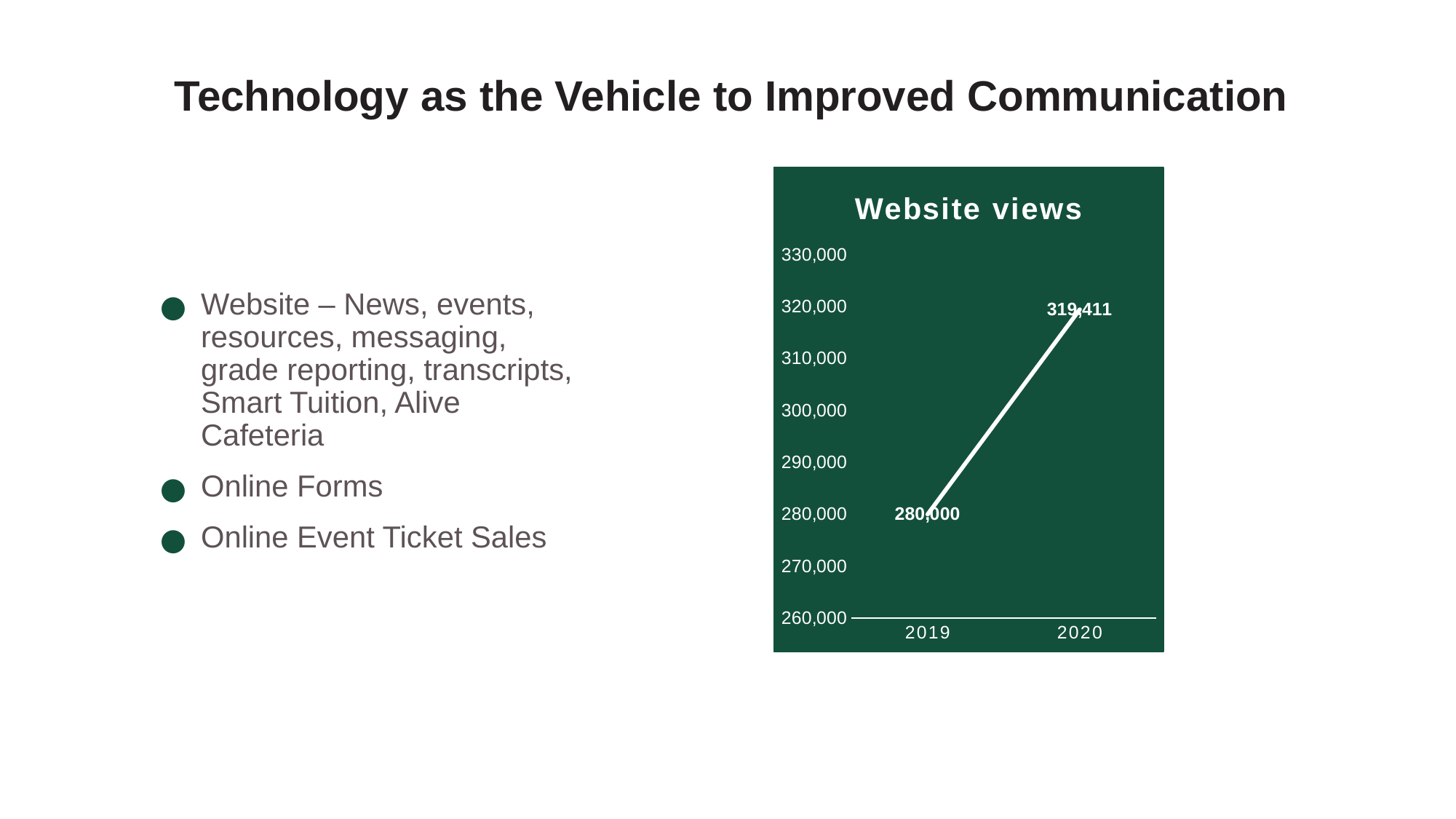
What is the title of the chart on the slide? Website views Which year has the lowest website views? 2019 What is the value for 2020 in the Website views chart? 319,411 Is the value for 2020 greater or less than 310,000? greater Which is larger, the website views for 2019 or for 2020? 2020 What is the difference in website views between 2020 and 2019? 39,411 Which year has the highest website views? 2020 What is the value for 2019 in the Website views chart? 280,000 How many years are plotted in the Website views chart? 2 Do website views rise or fall from 2019 to 2020? rise What kind of chart is the Website views chart? line chart Is the value for 2019 greater or less than 290,000? less